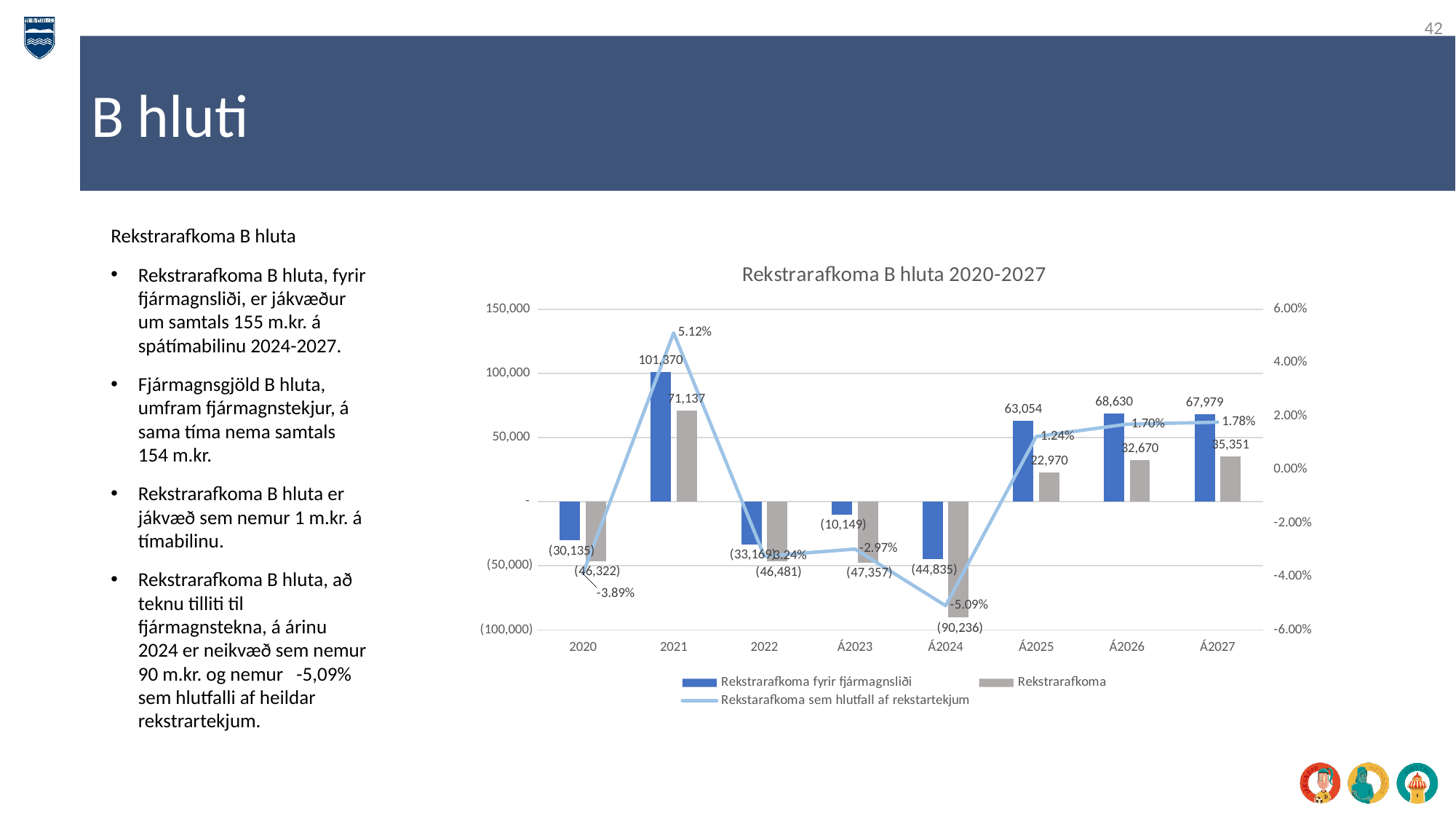
What is the difference between Rekstrarafkoma fyrir fjármagnsliði for Á2026 and Á2025? 5,576 How many series does the chart legend list? 3 How many years are shown on the x axis of the chart? 8 What is the title of the chart? Rekstrarafkoma B hluta 2020-2027 What is the value of Rekstrarafkoma for Á2024? (90,236) What is the value of Rekstrarafkoma fyrir fjármagnsliði for 2021? 101,370 What is the difference between Rekstrarafkoma fyrir fjármagnsliði and Rekstrarafkoma in 2021? 30,233 What is the value of Rekstrarafkoma sem hlutfall af rekstartekjum for Á2027? 1.78% Which is larger, Rekstrarafkoma for Á2027 or for Á2026? Á2027 Which year has the lowest value for Rekstrarafkoma? Á2024 Which year has the highest value for Rekstrarafkoma fyrir fjármagnsliði? 2021 What is the value of Rekstrarafkoma sem hlutfall af rekstartekjum for 2021? 5.12%